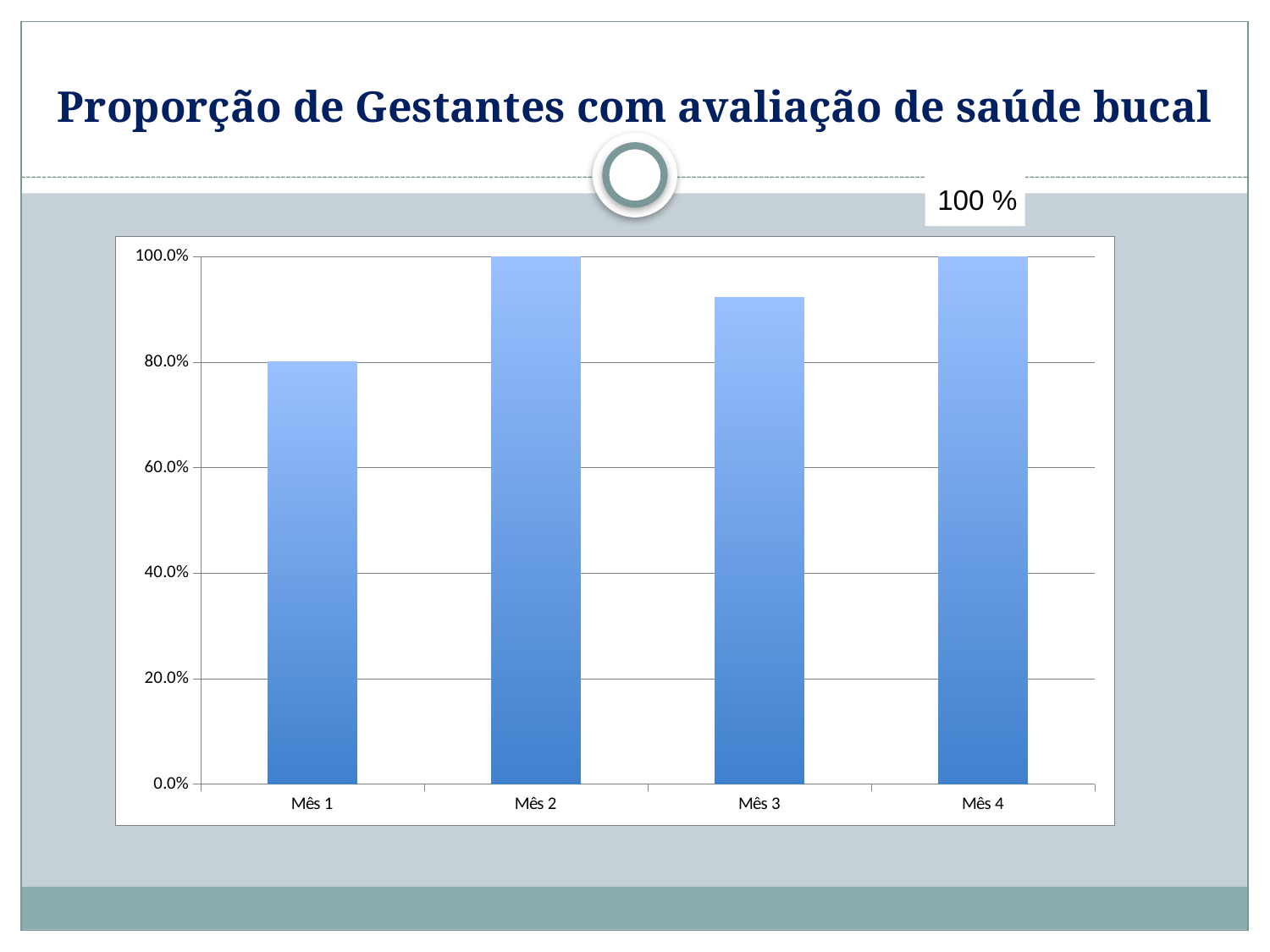
Is the value for Mês 3 greater or less than 80.0%? greater What is the value for Mês 1? 80.0% What is the difference between the values for Mês 2 and Mês 1? 20.0% How many months are shown on the x axis? 4 What is the value for Mês 2? 100.0% Which month has the lowest value? Mês 1 Does the value rise or fall from Mês 1 to Mês 2? Rise What is the title of the slide? Proporção de Gestantes com avaliação de saúde bucal What is the value for Mês 4? 100.0% Which is larger, the value for Mês 1 or the value for Mês 3? Mês 3 Is the value for Mês 3 greater or less than 100.0%? less What kind of chart is shown on the slide? Bar chart